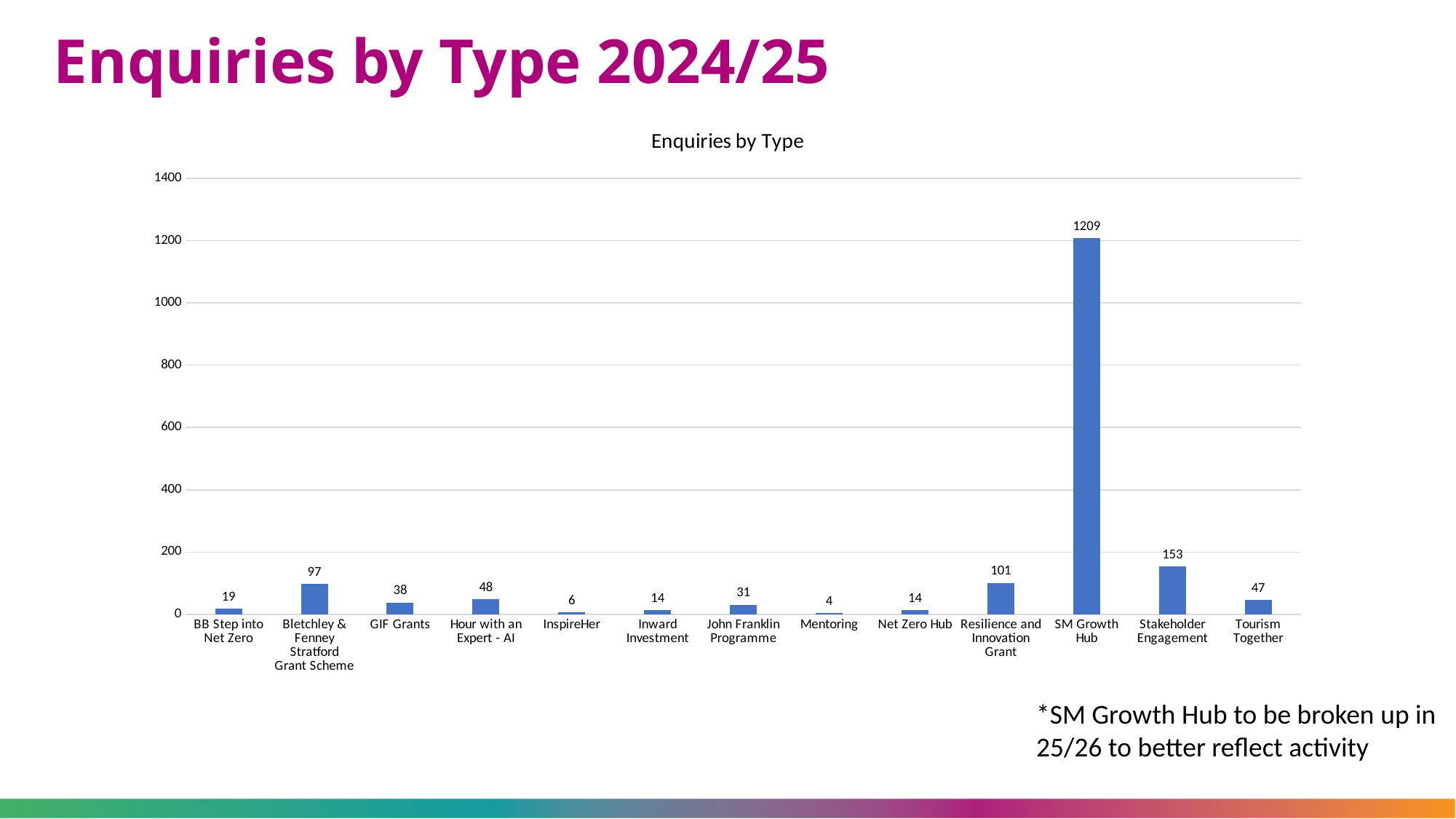
Which is larger, Tourism Together or John Franklin Programme? Tourism Together What is the value for Stakeholder Engagement? 153 What kind of chart is this? Bar chart What is the difference between SM Growth Hub and Stakeholder Engagement? 1056 What is the value for SM Growth Hub? 1209 What is the difference between Hour with an Expert - AI and GIF Grants? 10 How many categories are shown on the x axis? 13 What is the title of the chart? Enquiries by Type Which category has the lowest value? Mentoring Which category has the highest value? SM Growth Hub What is the value for Resilience and Innovation Grant? 101 What is the value for Bletchley & Fenney Stratford Grant Scheme? 97